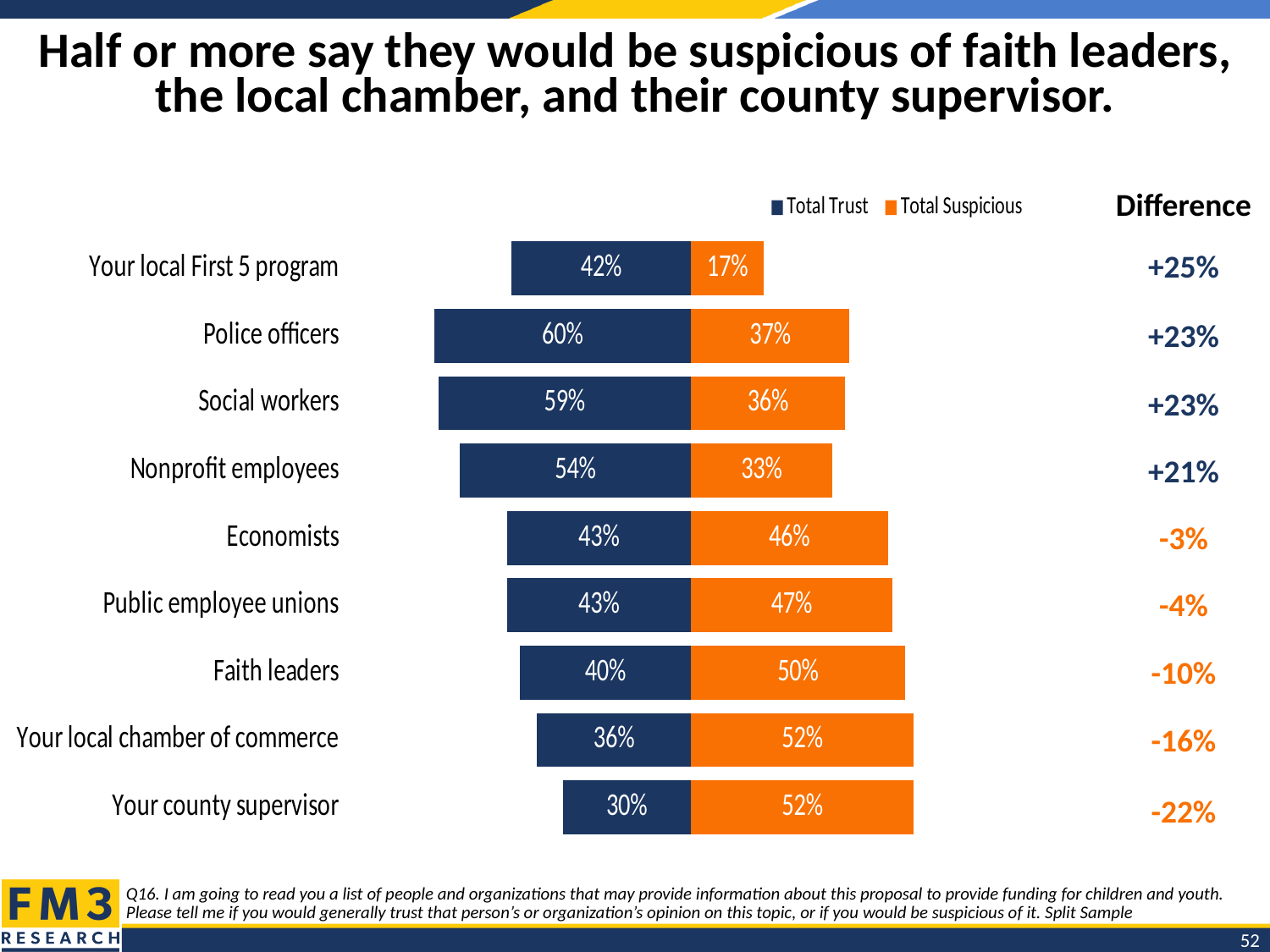
What is the Difference value shown for your local chamber of commerce? -16% What percentage say they would trust police officers (Total Trust)? 60% How many series does the legend list? 2 What is the Total Suspicious value for faith leaders? 50% What is the difference between Total Trust and Total Suspicious for nonprofit employees? +21% What is the Total Trust value for your county supervisor? 30% Which is larger for economists: Total Trust or Total Suspicious? Total Suspicious What kind of chart is shown on the slide? Bar chart Which category has the lowest Total Suspicious value? Your local First 5 program Which colour represents Total Suspicious in the chart? Orange How many categories (people or organizations) are shown in the chart? 9 Which category has the highest Total Trust value? Police officers